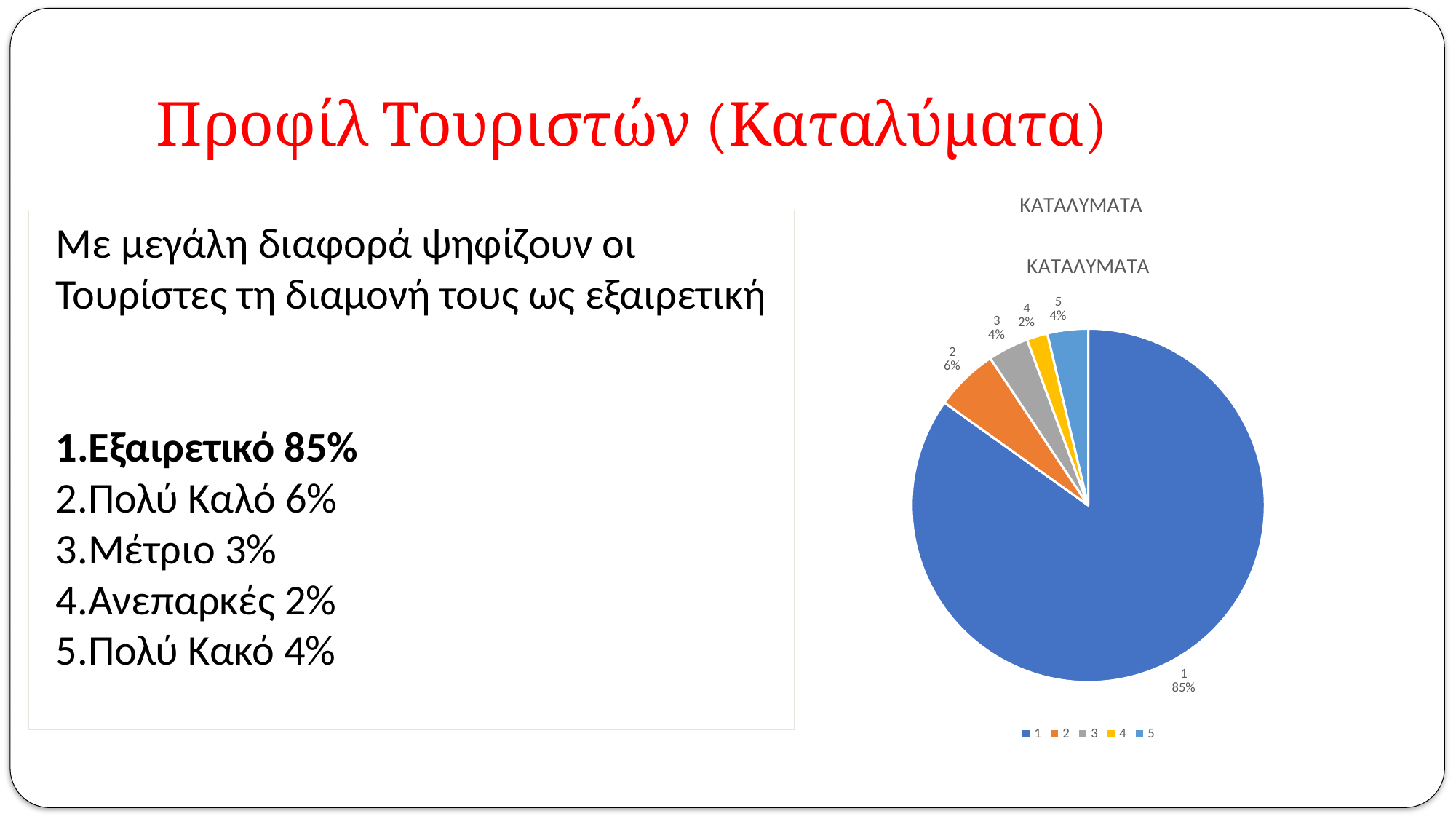
How many slices does the pie chart have? 5 What percentage is shown for slice 2 in the pie chart? 6% What percentage is shown for slice 1 in the pie chart? 85% What is the title of the pie chart? ΚΑΤΑΛΥΜΑΤΑ What percentage is shown for slice 5 in the pie chart? 4% What is the difference in percentage points between slice 1 and slice 2 in the pie chart? 79 What kind of chart is shown on the slide? pie chart How many entries does the legend of the pie chart list? 5 Which slice of the pie chart is the largest? 1 Which slice of the pie chart is the smallest? 4 Which is larger in the pie chart, slice 2 or slice 4? slice 2 What percentage is shown for slice 4 in the pie chart? 2%